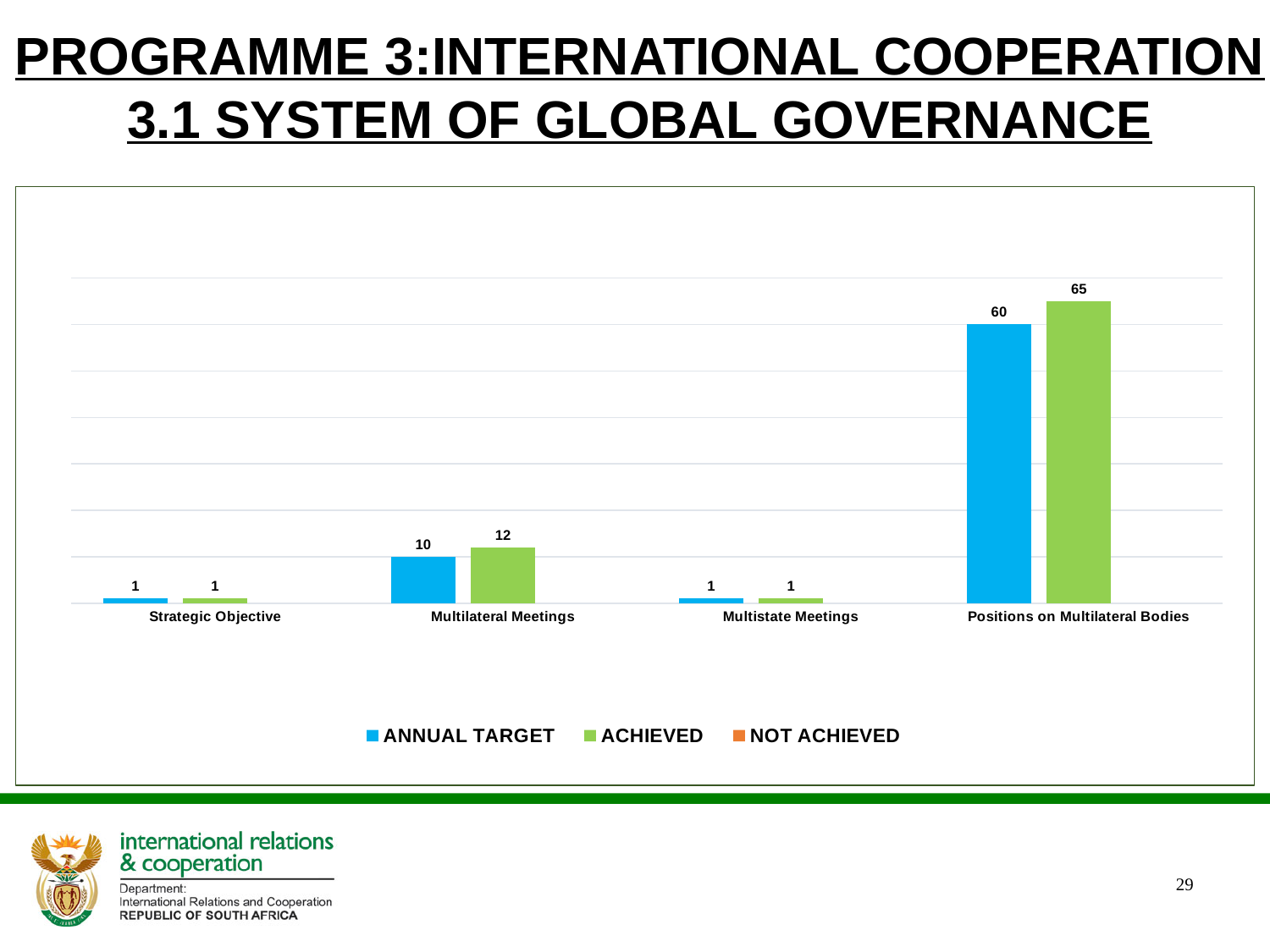
What is the ANNUAL TARGET value for Positions on Multilateral Bodies? 60 What kind of chart is shown on the slide? Bar chart What is the difference between the ACHIEVED and ANNUAL TARGET values for Positions on Multilateral Bodies? 5 What colour represents the ACHIEVED series in the legend? Green How many series does the legend list? 3 How many categories are shown on the x axis? 4 Which is larger for Multilateral Meetings, the ANNUAL TARGET or the ACHIEVED value? ACHIEVED What is the ANNUAL TARGET value for Multistate Meetings? 1 What is the difference between the ACHIEVED and ANNUAL TARGET values for Multilateral Meetings? 2 Which category has the highest ACHIEVED value? Positions on Multilateral Bodies What is the ACHIEVED value for Multilateral Meetings? 12 What is the ACHIEVED value for Strategic Objective? 1